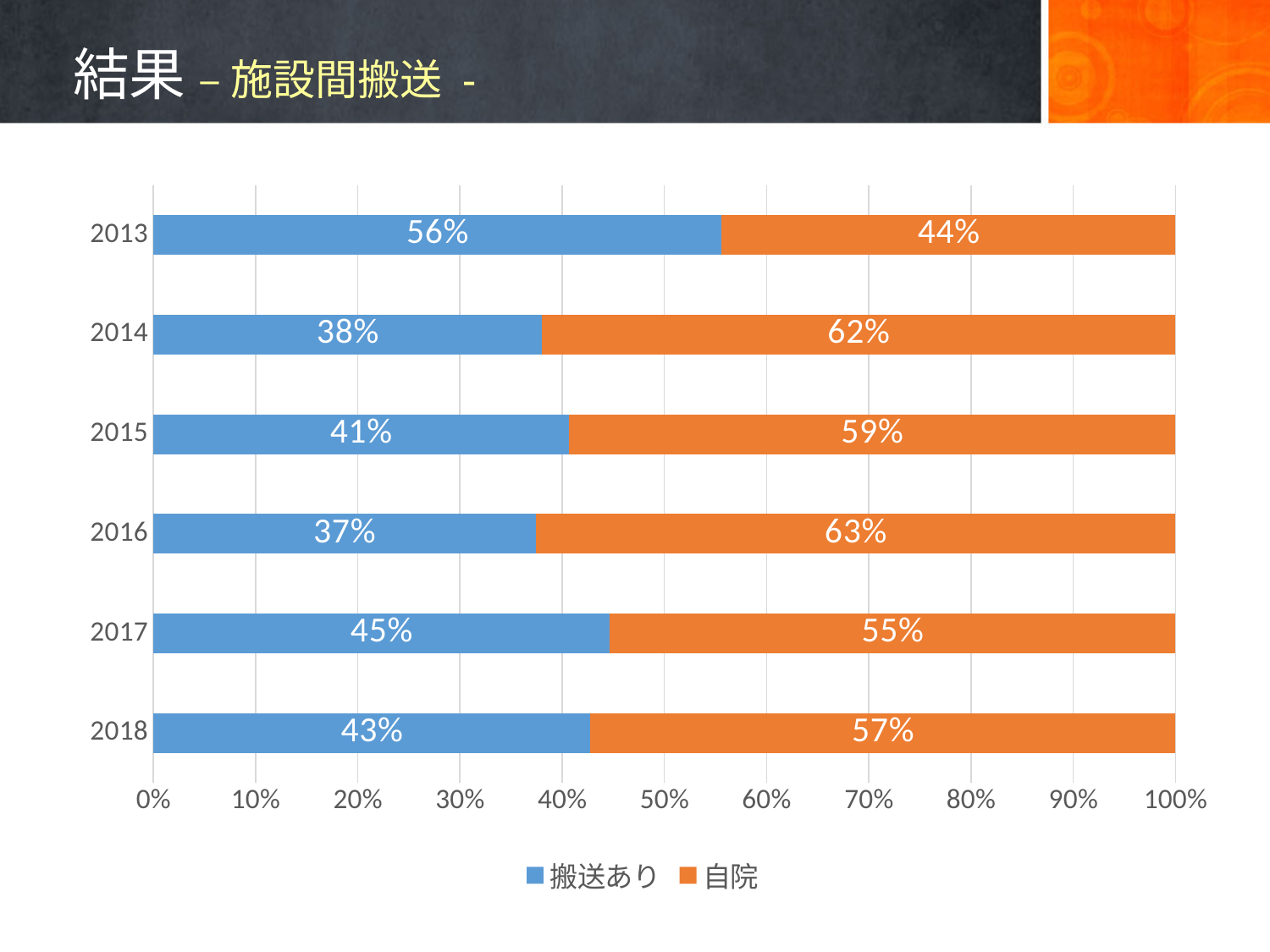
What is the value for 自院 in 2016? 63% Which is larger in 2015, 搬送あり or 自院? 自院 Which year has the lowest value for 搬送あり? 2016 What is the difference between the 自院 value and the 搬送あり value in 2014? 24% What is the value for 自院 in 2018? 57% Which year has the highest value for 自院? 2016 How many series does the legend list? 2 How many years are shown on the chart? 6 What is the value for 搬送あり in 2013? 56% What kind of chart is shown on the slide? Stacked bar chart Which year has the highest value for 搬送あり? 2013 What is the value for 搬送あり in 2017? 45%